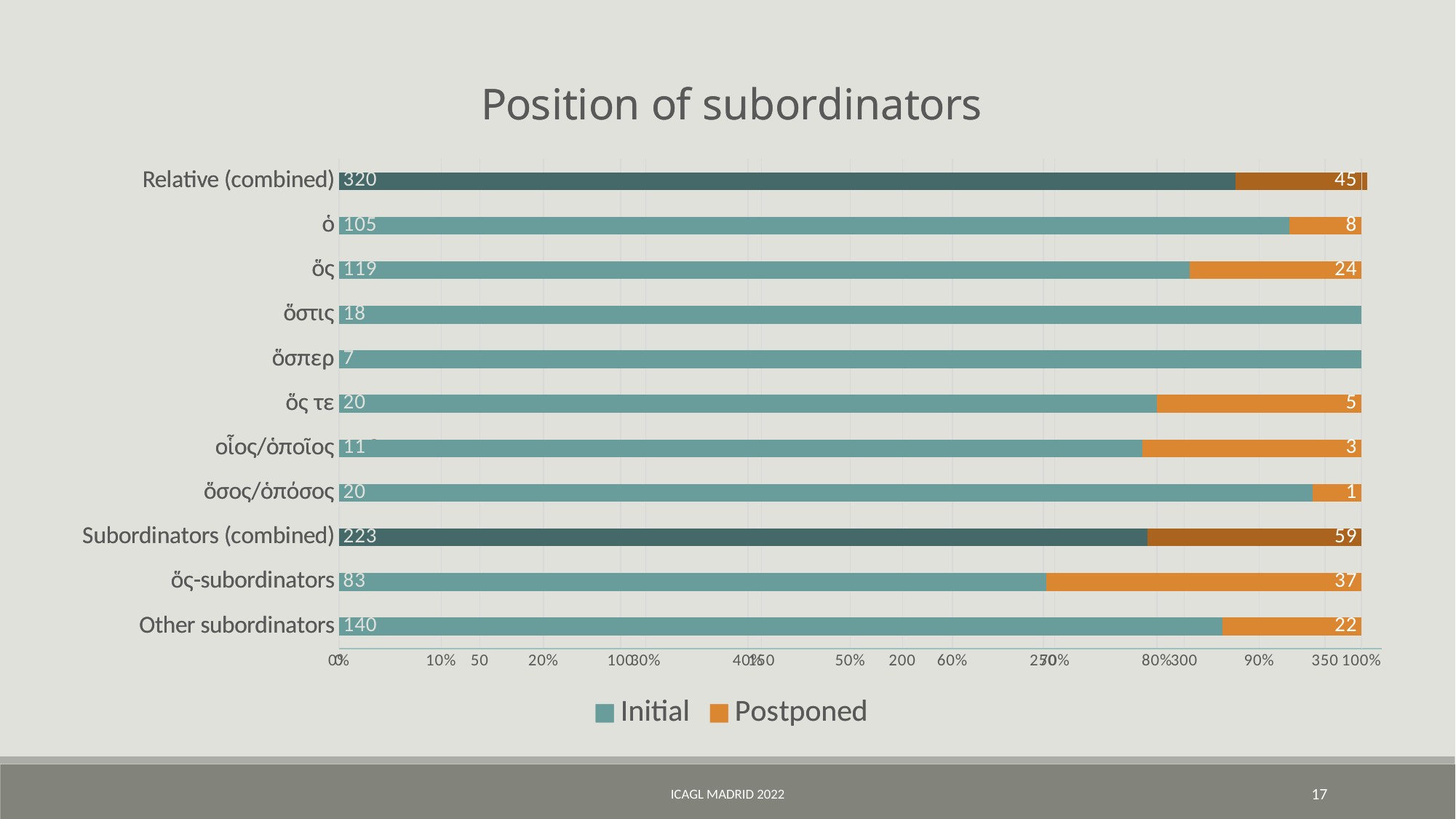
Which category has the highest Initial value? Relative (combined) Which category has the lowest Initial value? ὅσπερ How many series does the legend list? 2 What is the Initial value for Relative (combined)? 320 What is the Postponed value for ὅς-subordinators? 37 What is the total of the Initial and Postponed values for Relative (combined)? 365 What kind of chart is shown on the slide? Stacked bar chart Which has a larger Postponed value, ὅς or ὁ? ὅς What is the difference between the Initial and Postponed values for Subordinators (combined)? 164 What is the Initial value for Other subordinators? 140 How many categories are shown on the chart? 11 What is the Postponed value for Subordinators (combined)? 59